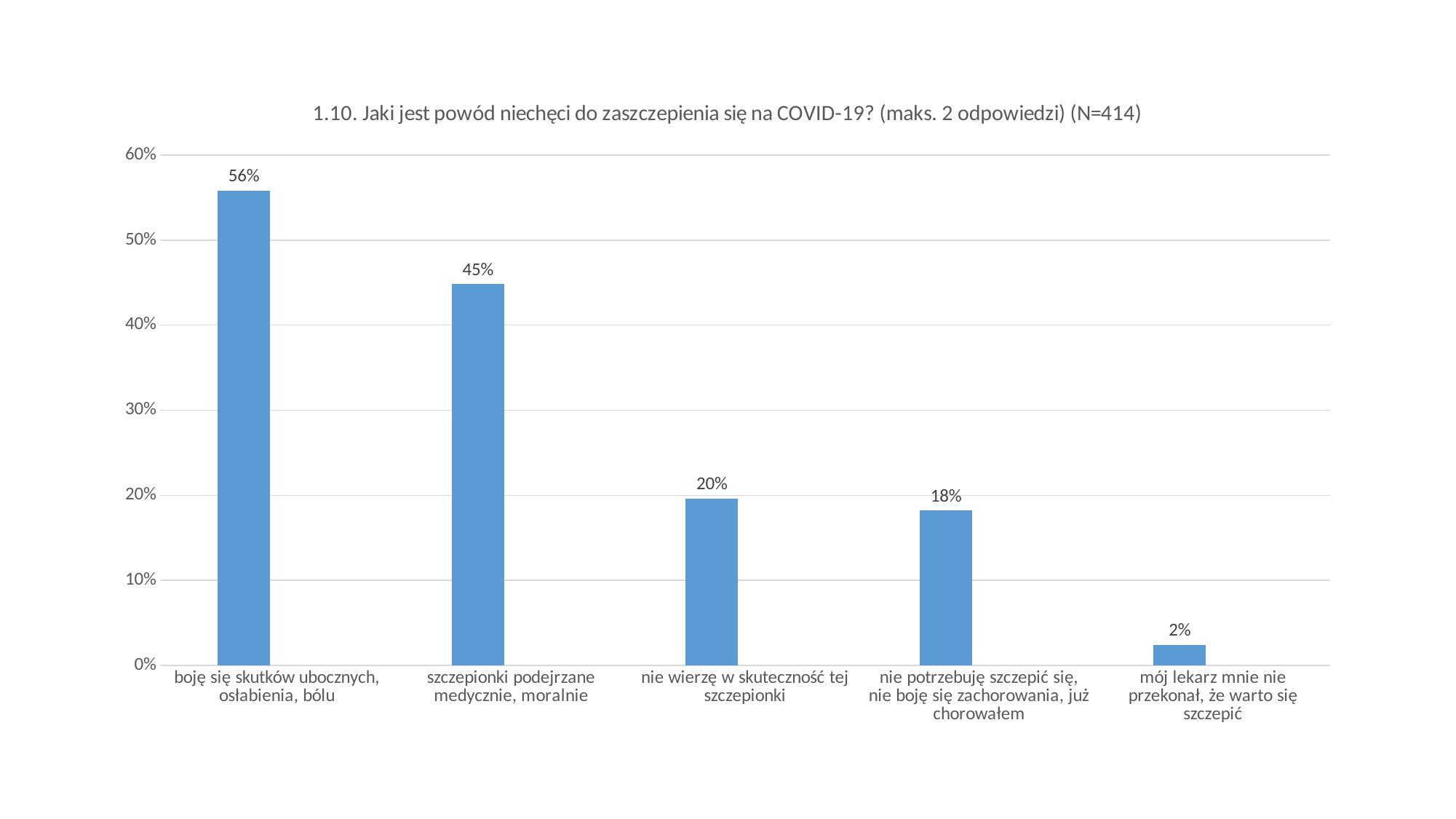
What kind of chart is shown on the slide? bar chart What is the value for "mój lekarz mnie nie przekonał, że warto się szczepić"? 2% What is the value for "boję się skutków ubocznych, osłabienia, bólu"? 56% What is the value for "nie wierzę w skuteczność tej szczepionki"? 20% Which category has the highest value? boję się skutków ubocznych, osłabienia, bólu Is the value for "szczepionki podejrzane medycznie, moralnie" greater or less than 40%? greater What is the value for "szczepionki podejrzane medycznie, moralnie"? 45% What is the sample size (N) given in the chart title? 414 How many categories are shown in the chart? 5 Which is larger: the value for "nie wierzę w skuteczność tej szczepionki" or for "nie potrzebuję szczepić się, nie boję się zachorowania, już chorowałem"? nie wierzę w skuteczność tej szczepionki What is the difference between the values for "boję się skutków ubocznych, osłabienia, bólu" and "szczepionki podejrzane medycznie, moralnie"? 11% Which category has the lowest value? mój lekarz mnie nie przekonał, że warto się szczepić